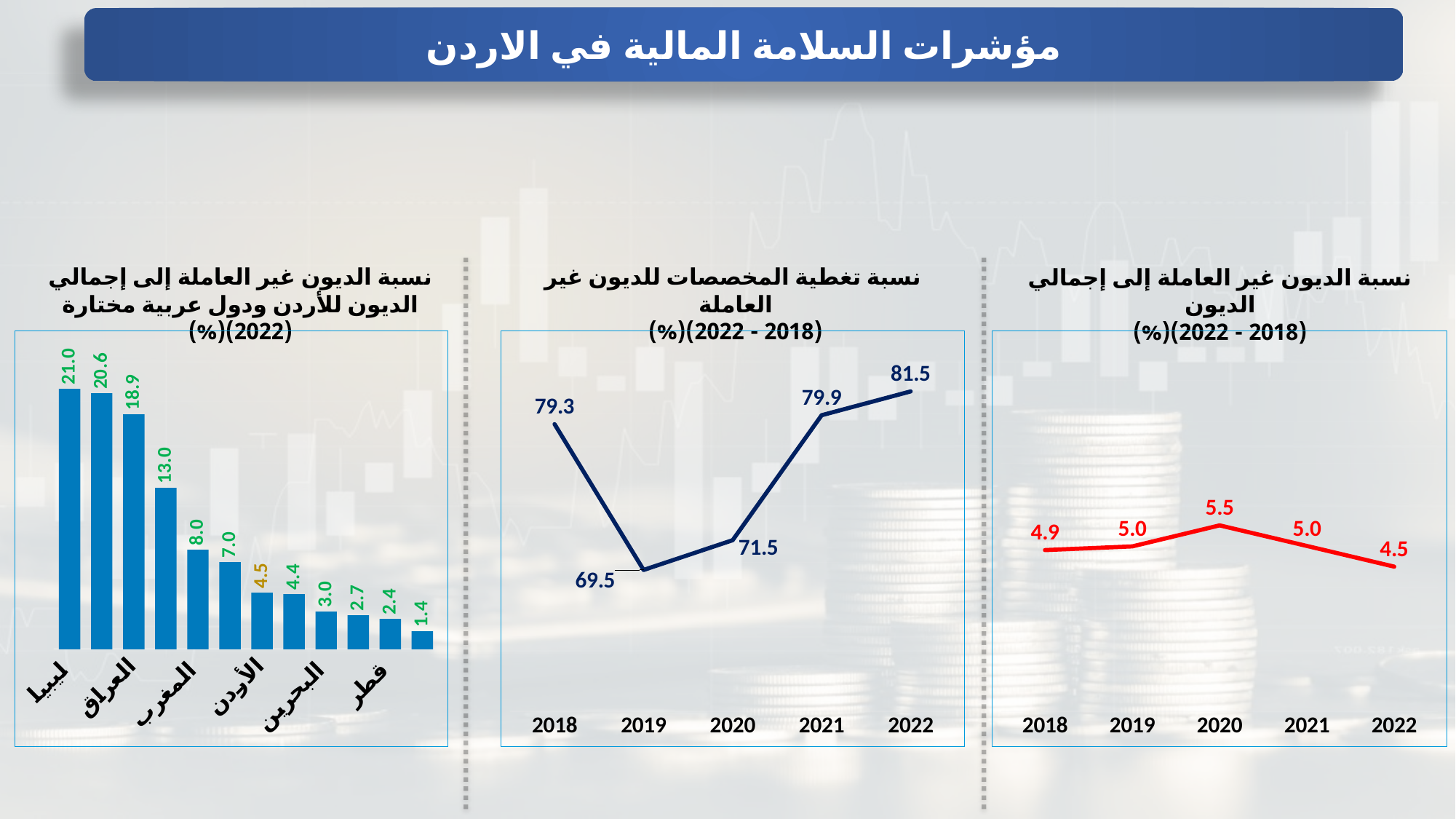
In the middle chart (نسبة تغطية المخصصات للديون غير العاملة), what is the value for 2019? 69.5 In the left chart (نسبة الديون غير العاملة إلى إجمالي الديون للأردن ودول عربية مختارة), what is the value of the highest bar? 21.0 In the middle chart (نسبة تغطية المخصصات للديون غير العاملة), what is the difference between the 2022 value and the 2018 value? 2.2 In the middle chart (نسبة تغطية المخصصات للديون غير العاملة), which year has the lowest value? 2019 What kind of chart is the left chart (نسبة الديون غير العاملة إلى إجمالي الديون للأردن ودول عربية مختارة)? bar chart In the right chart (نسبة الديون غير العاملة إلى إجمالي الديون), what is the value for 2020? 5.5 In the right chart (نسبة الديون غير العاملة إلى إجمالي الديون), which year has the lowest value? 2022 In the right chart (نسبة الديون غير العاملة إلى إجمالي الديون), what is the difference between the 2020 value and the 2022 value? 1.0 In the left chart (نسبة الديون غير العاملة إلى إجمالي الديون للأردن ودول عربية مختارة), what is the value for الأردن? 4.5 In the right chart (نسبة الديون غير العاملة إلى إجمالي الديون), is the value for 2018 larger or smaller than the value for 2020? smaller In the middle chart (نسبة تغطية المخصصات للديون غير العاملة), how many years are plotted? 5 In the middle chart (نسبة تغطية المخصصات للديون غير العاملة), which year has the highest value? 2022